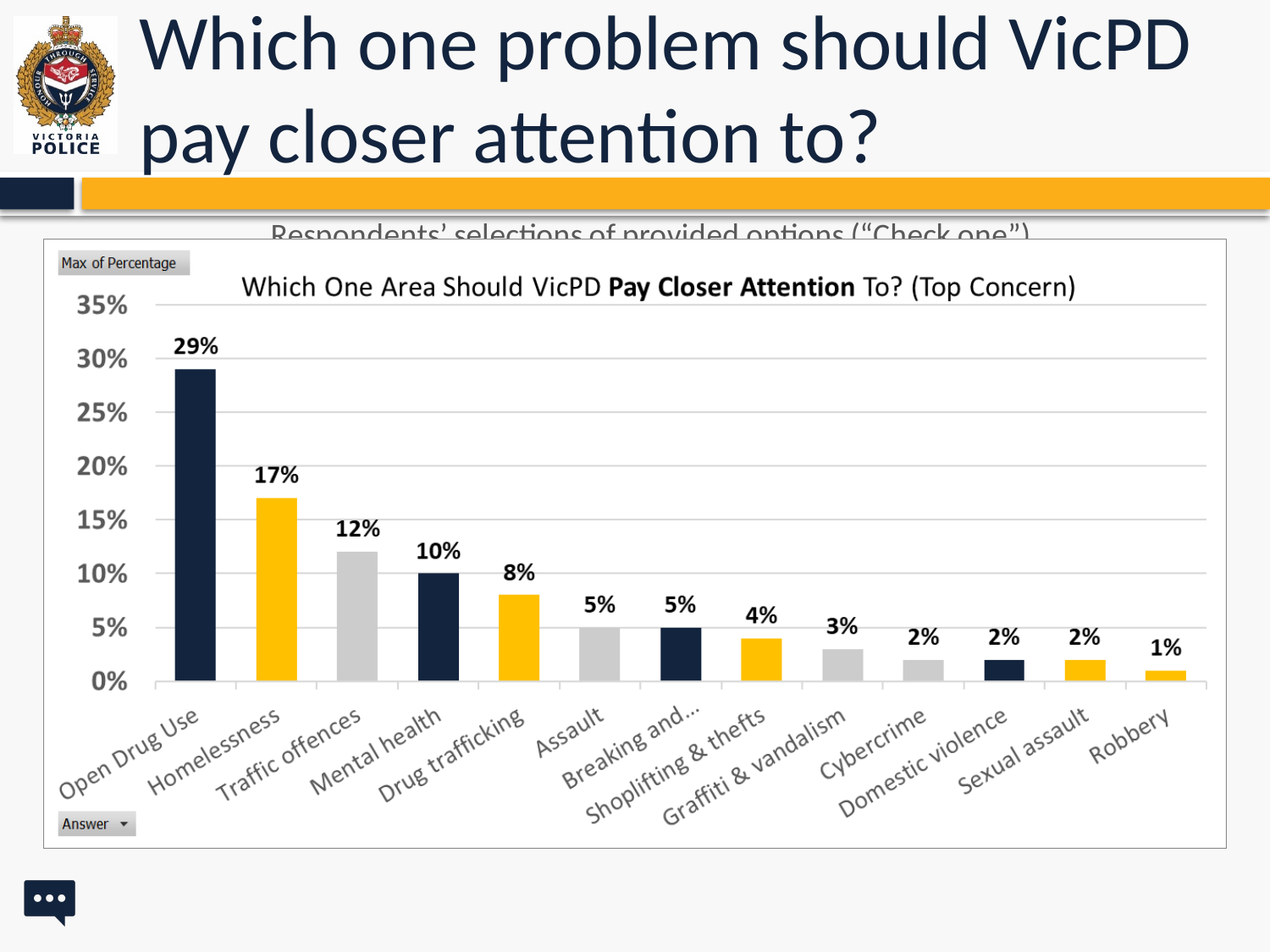
What percentage is shown for Mental health? 10% What percentage of respondents selected Open Drug Use as the one area VicPD should pay closer attention to? 29% How many categories are shown on the x axis of the chart? 13 What is the difference between the values for Traffic offences and Drug trafficking? 4% What type of chart is shown on the slide? Bar chart Which is larger, the value for Mental health or the value for Assault? Mental health What is the value for Cybercrime? 2% What is the difference between the values for Open Drug Use and Homelessness? 12% Which category has the lowest value in the chart? Robbery What is the value shown for Homelessness? 17% Which category has the highest value in the chart? Open Drug Use Do the values rise or fall moving from left to right along the x axis? Fall